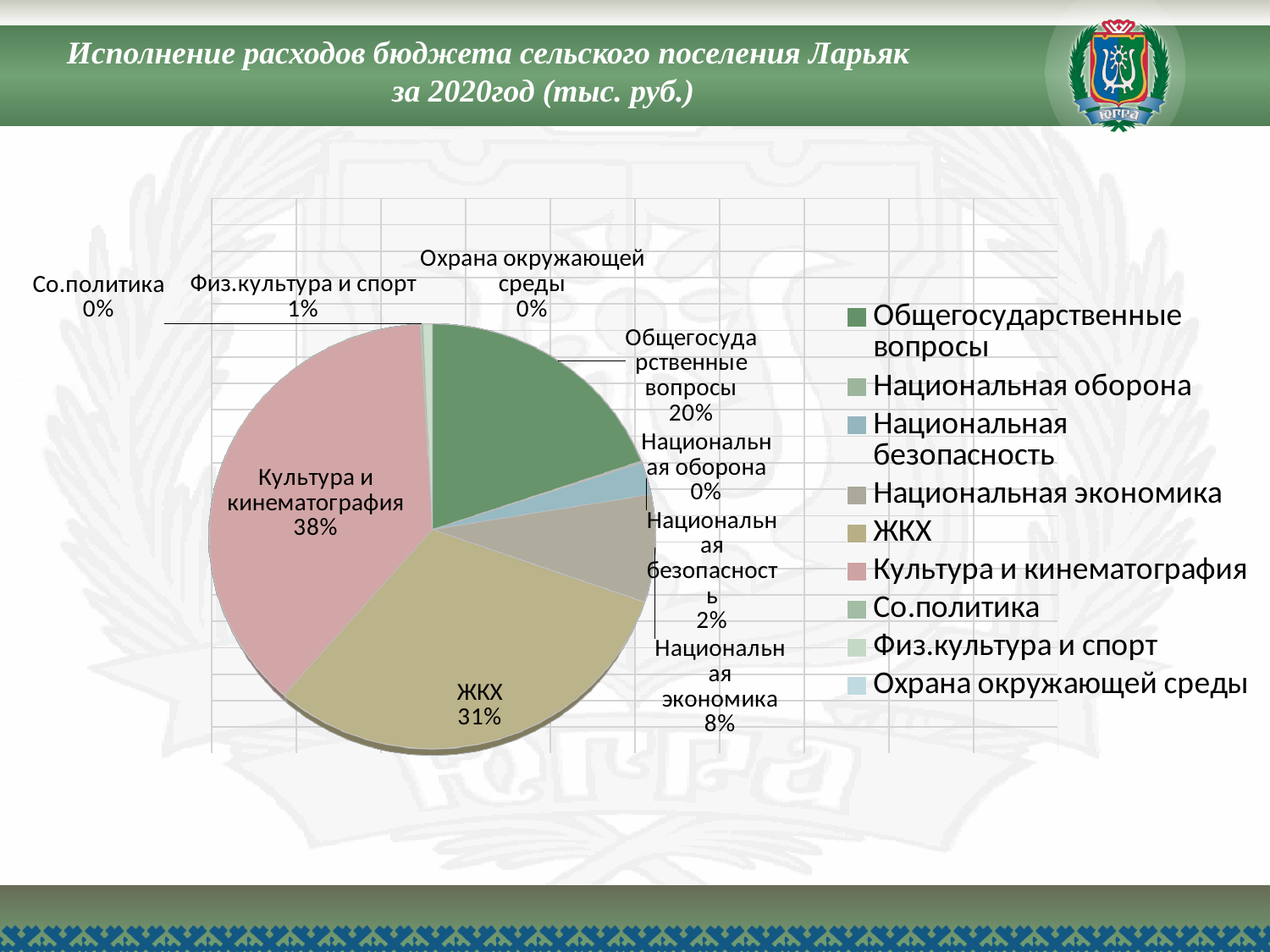
Which is larger, the share for ЖКХ or the share for Общегосударственные вопросы? ЖКХ What share of the pie does Национальная безопасность have? 2% What kind of chart is shown on the slide? Pie chart What is the title of the slide? Исполнение расходов бюджета сельского поселения Ларьяк за 2020год (тыс. руб.) Which category has the largest slice of the pie? Культура и кинематография What share of the pie does Культура и кинематография have? 38% What share of the pie does Национальная экономика have? 8% What is the difference in percentage points between the shares of Культура и кинематография and ЖКХ? 7% How many entries does the legend list? 9